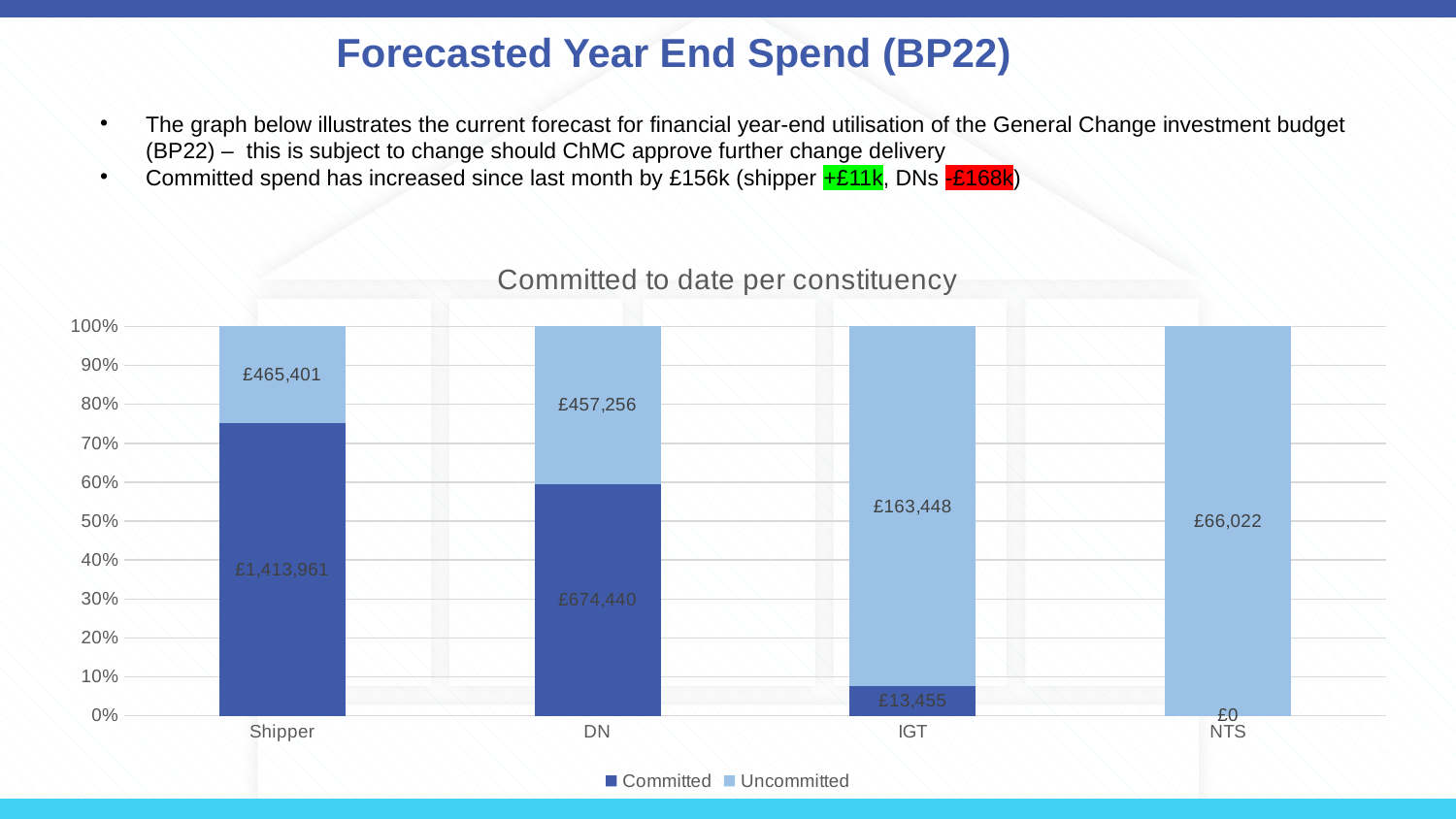
How many series does the legend list? 2 What is the Uncommitted value for NTS? £66,022 Which is larger, the Uncommitted value for Shipper or the Uncommitted value for DN? Shipper Is the Committed share of the Shipper bar greater or less than 70%? greater What is the Uncommitted value for DN? £457,256 What is the total of the Committed and Uncommitted values for IGT? £176,903 How many constituencies are shown on the x axis? 4 What is the difference between the Committed values for Shipper and DN? £739,521 What is the Committed value for IGT? £13,455 Which constituency has the highest Committed value? Shipper Which constituency has the lowest Uncommitted value? NTS What is the Committed value for Shipper? £1,413,961